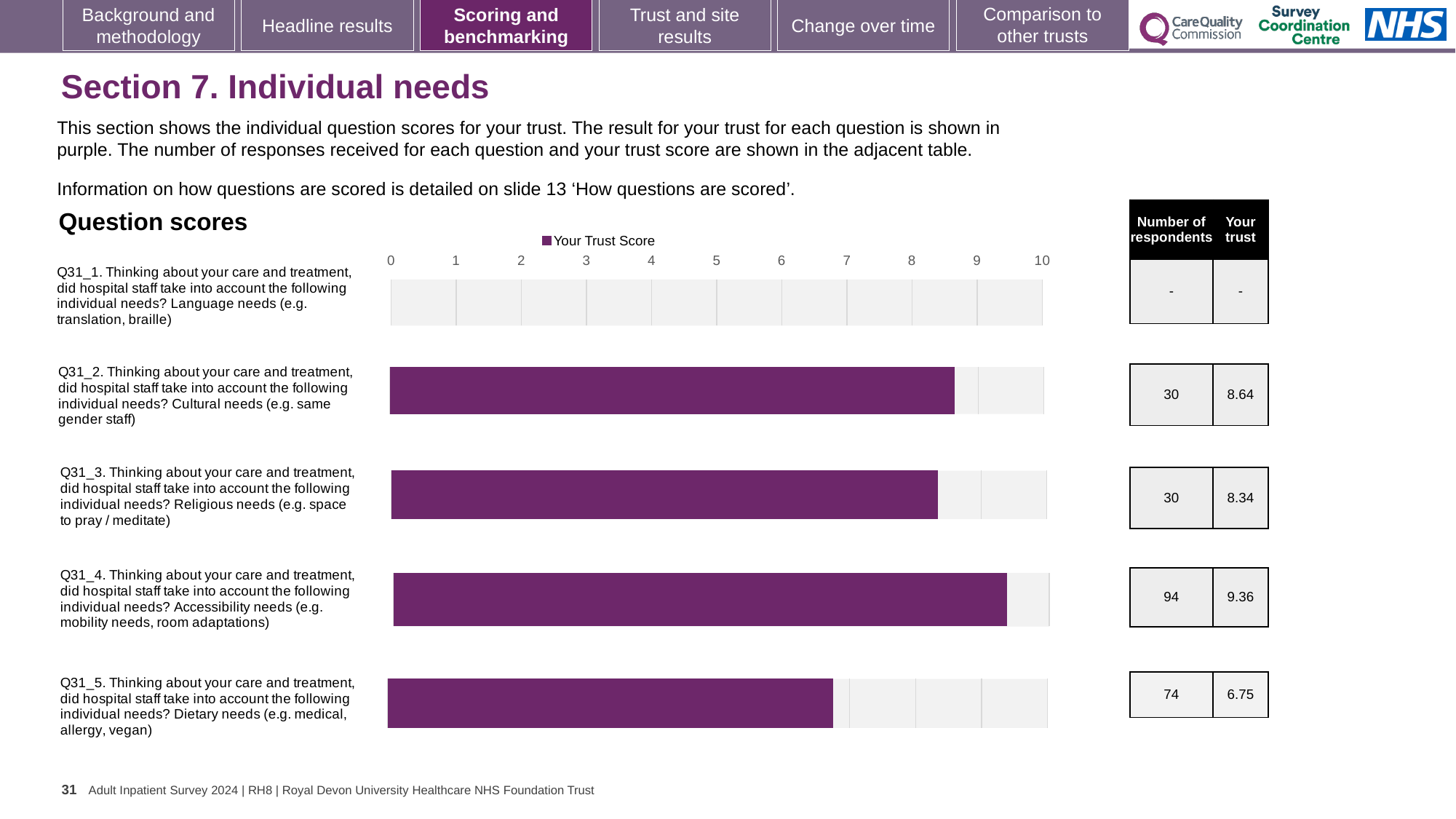
Is the trust score for Q31_5 (Dietary needs) greater or less than 7? less What is the name of the series shown in the chart legend? Your Trust Score What kind of chart is used to show the question scores? Bar chart What is the trust score for Q31_5 (Dietary needs)? 6.75 How many questions (categories) are listed on the chart? 5 Which question with a plotted bar has the lowest trust score? Q31_5 (Dietary needs) What is the trust score for Q31_4 (Accessibility needs)? 9.36 Which has the higher trust score, Q31_2 (Cultural needs) or Q31_3 (Religious needs)? Q31_2 (Cultural needs) Which question has the highest trust score? Q31_4 (Accessibility needs) How many respondents answered Q31_2 (Cultural needs)? 30 How many series does the chart legend list? 1 What is the difference between the trust scores for Q31_4 and Q31_5? 2.61